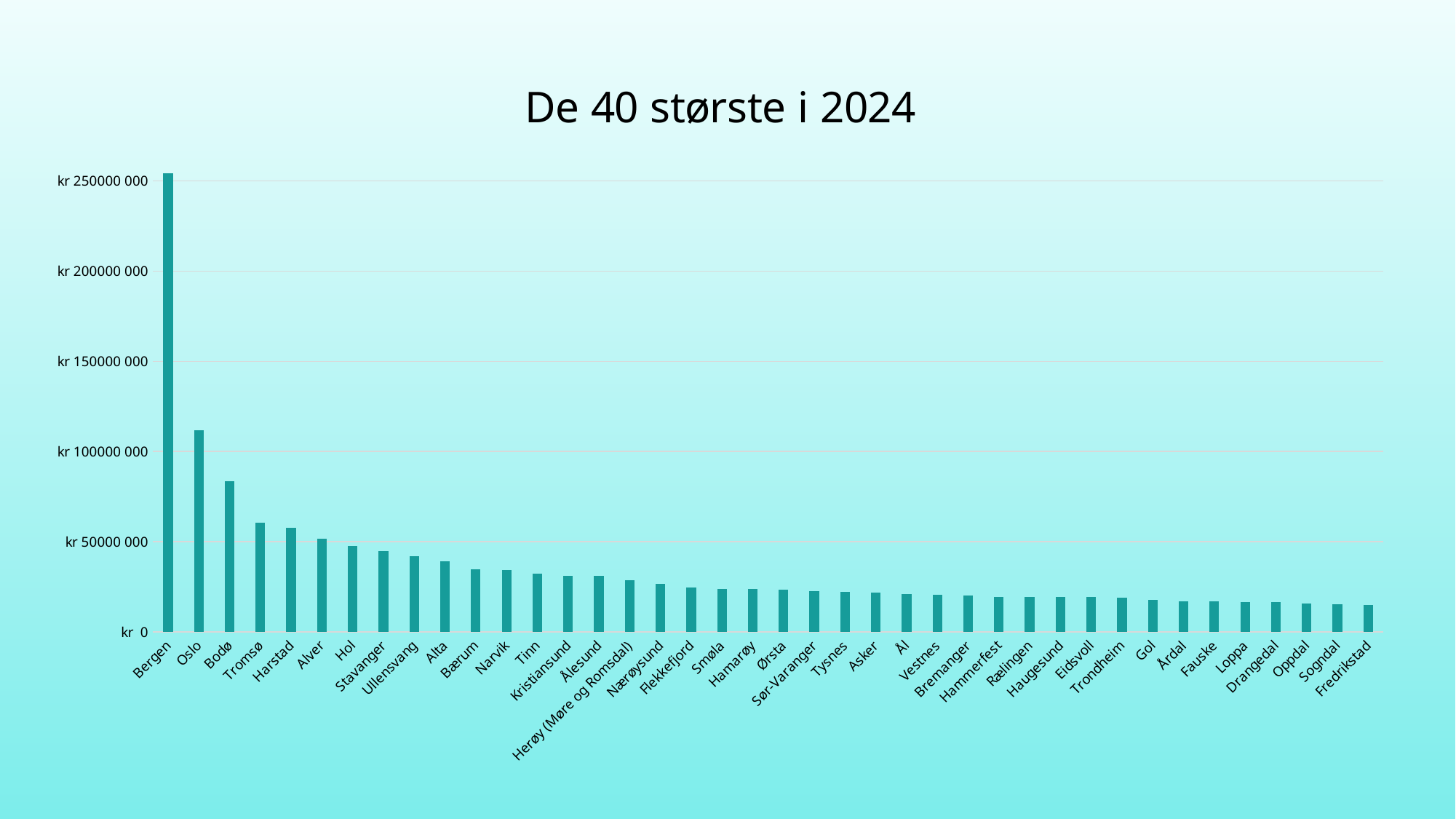
What kind of chart is shown on the slide? Bar chart Which has the larger value, Oslo or Bodø? Oslo Is the value for Bodø greater or less than kr 100000 000? less Is the value for Oslo greater or less than kr 100000 000? greater How many categories (municipalities) are plotted on the x axis? 40 Do the values rise or fall moving from left to right along the x axis? Fall What is the title of the chart? De 40 største i 2024 Is the value for Trondheim greater or less than kr 50000 000? less Which category has the lowest value? Fredrikstad Which category has the highest value? Bergen